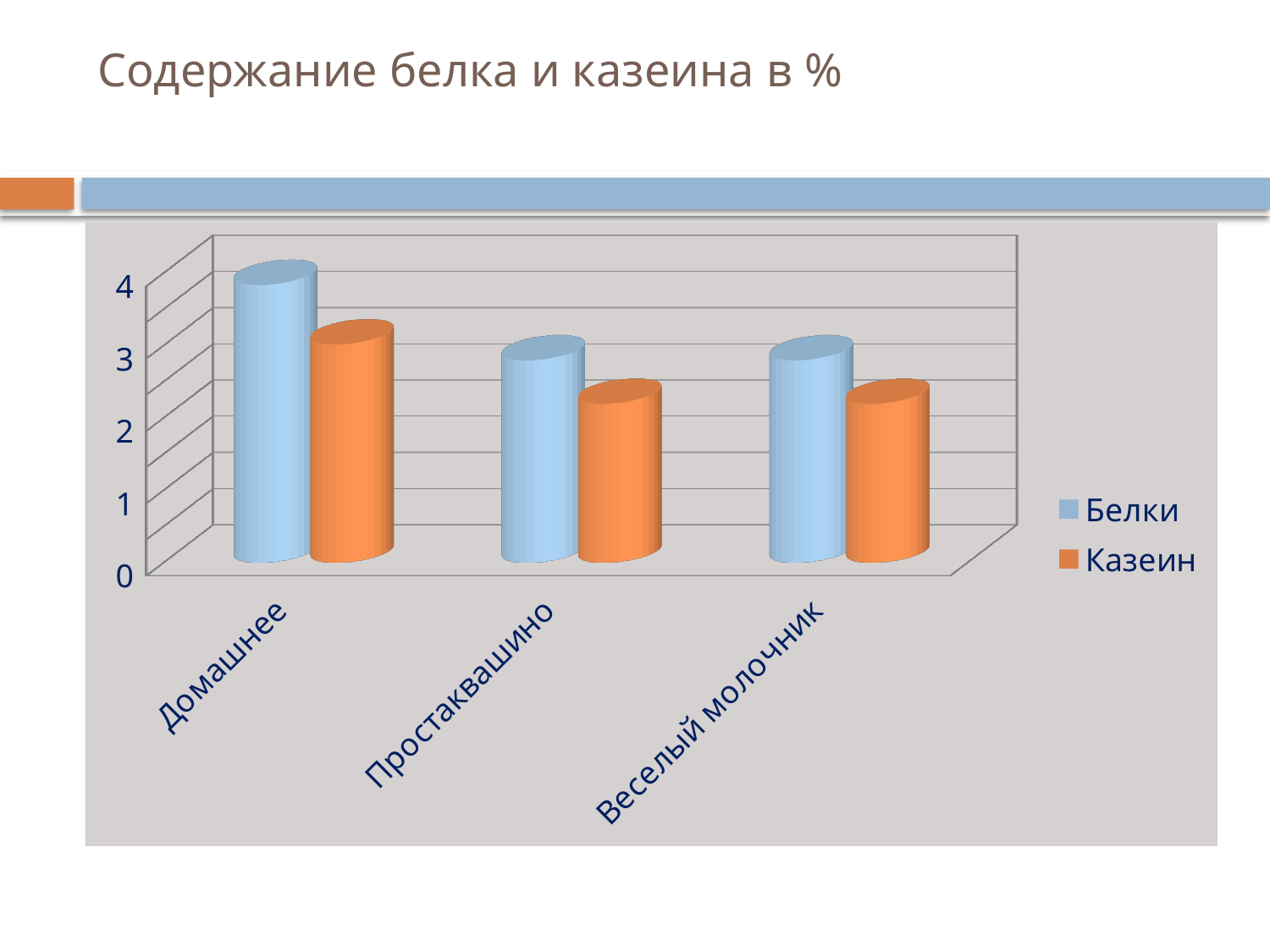
Which category has the highest Казеин value? Домашнее For Домашнее, which is larger: Белки or Казеин? Белки Is the Белки value for Домашнее greater or less than 3? greater Is the Казеин value for Простаквашино greater or less than 3? less Which is larger: the Белки value for Домашнее or the Белки value for Простаквашино? Домашнее How many categories are shown on the x axis? 3 Which series is shown in orange? Казеин Which category has the highest Белки value? Домашнее What is the title of the chart on the slide? Содержание белка и казеина в % What kind of chart is shown on the slide? bar chart How many series does the legend list? 2